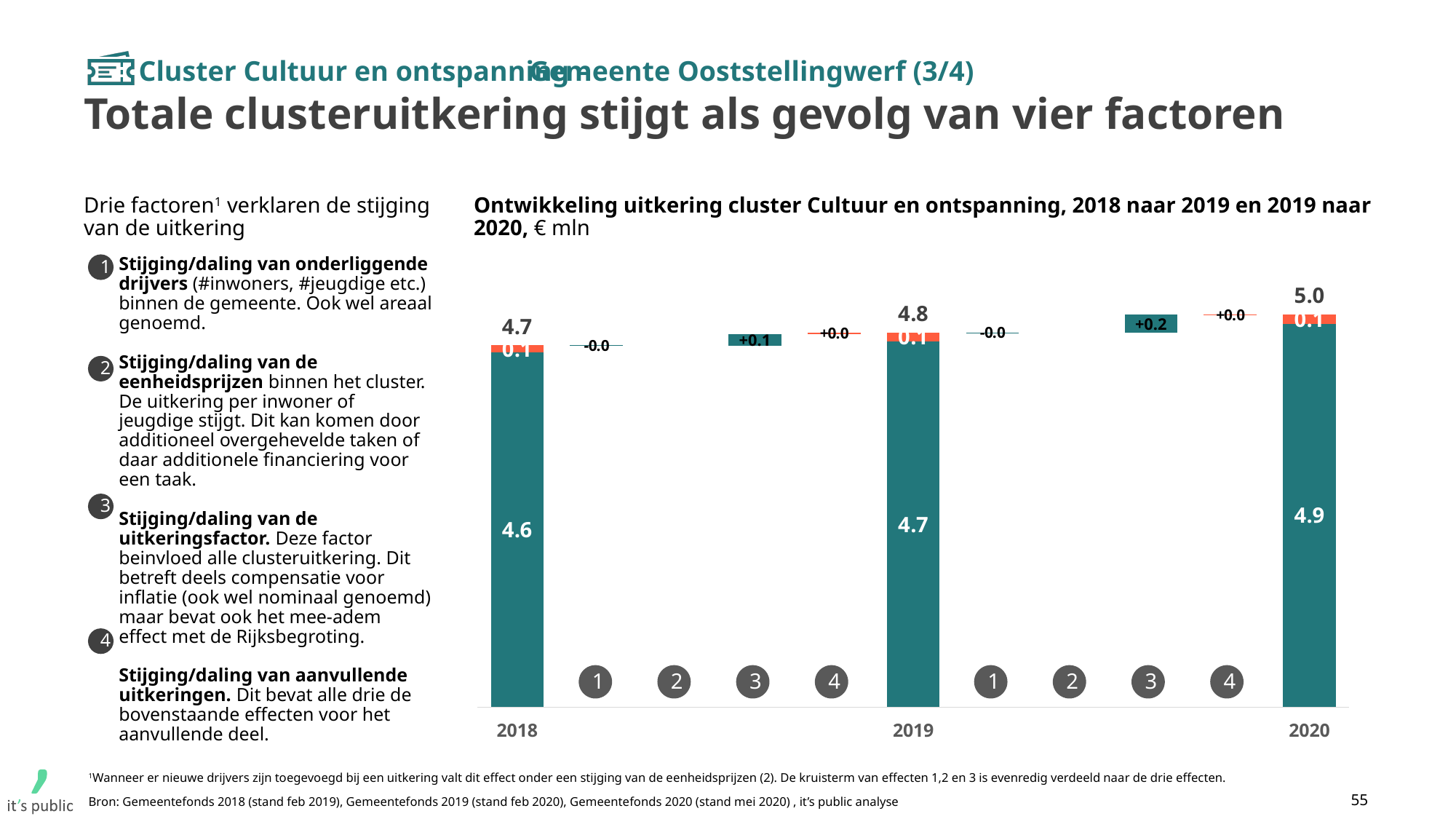
What is the total uitkering for the cluster Cultuur en ontspanning in 2018? 4.7 Which year has the lowest total uitkering in the chart? 2018 Is the total uitkering larger in 2019 or in 2020? 2020 Which year has the highest total uitkering in the chart? 2020 What is the total uitkering for the cluster Cultuur en ontspanning in 2020? 5.0 What is the value of the larger (teal) segment of the 2019 bar? 4.7 What is the difference between the total uitkering in 2020 and in 2018? 0.3 Does the total uitkering rise or fall from 2018 to 2020? rise In what unit are the values in the chart expressed? € mln What is the value of the small orange segment on top of the 2020 bar? 0.1